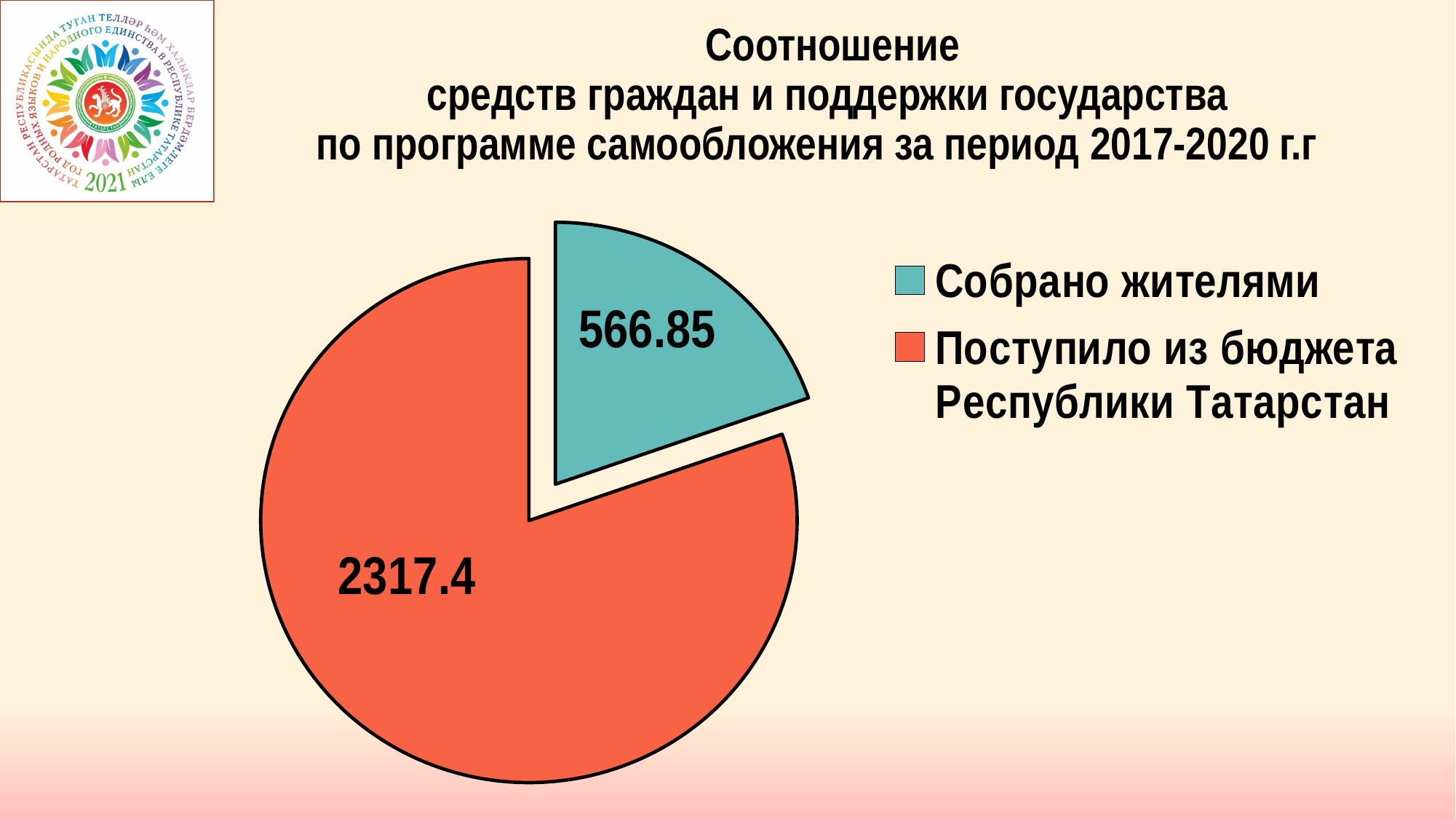
What is the total of the two values shown in the pie chart? 2884.25 Which is larger: the value for "Собрано жителями" or the value for "Поступило из бюджета Республики Татарстан"? Поступило из бюджета Республики Татарстан What type of chart is shown on the slide? pie chart What is the value for "Поступило из бюджета Республики Татарстан"? 2317.4 What period does the chart title say the data covers? 2017-2020 г.г Which category has the smallest slice of the pie? Собрано жителями What is the value for "Собрано жителями"? 566.85 How many slices does the pie chart have? 2 What colour is the slice for "Собрано жителями"? teal How many entries does the legend list? 2 What is the difference between the value for "Поступило из бюджета Республики Татарстан" and the value for "Собрано жителями"? 1750.55 Which category has the largest slice of the pie? Поступило из бюджета Республики Татарстан